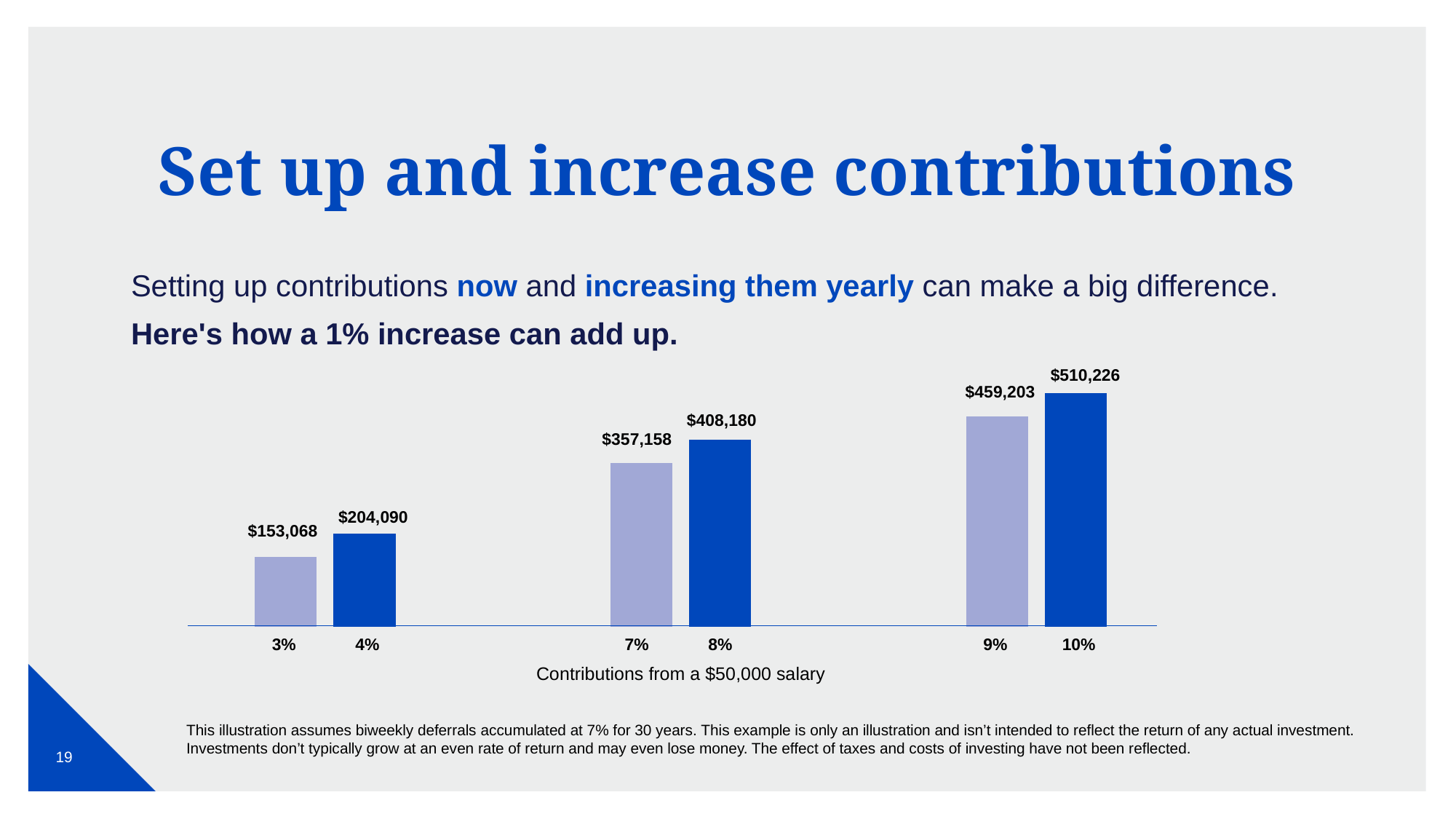
Which contribution rate has the highest value in the chart? 10% What is the difference between the values for the 10% and 9% contribution bars? $51,023 What is the difference between the values for the 4% and 3% contribution bars? $51,022 How many bars are plotted in the chart? 6 What kind of chart is shown on the slide? Bar chart Do the values rise or fall as the contribution rate increases along the x axis? Rise What is the value shown for the 8% contribution bar? $408,180 What is the x-axis title of the chart? Contributions from a $50,000 salary Which contribution rate has the lowest value in the chart? 3% What is the value shown for the 3% contribution bar? $153,068 Which is larger, the value for 7% or the value for 8%? 8% What is the value shown for the 10% contribution bar? $510,226